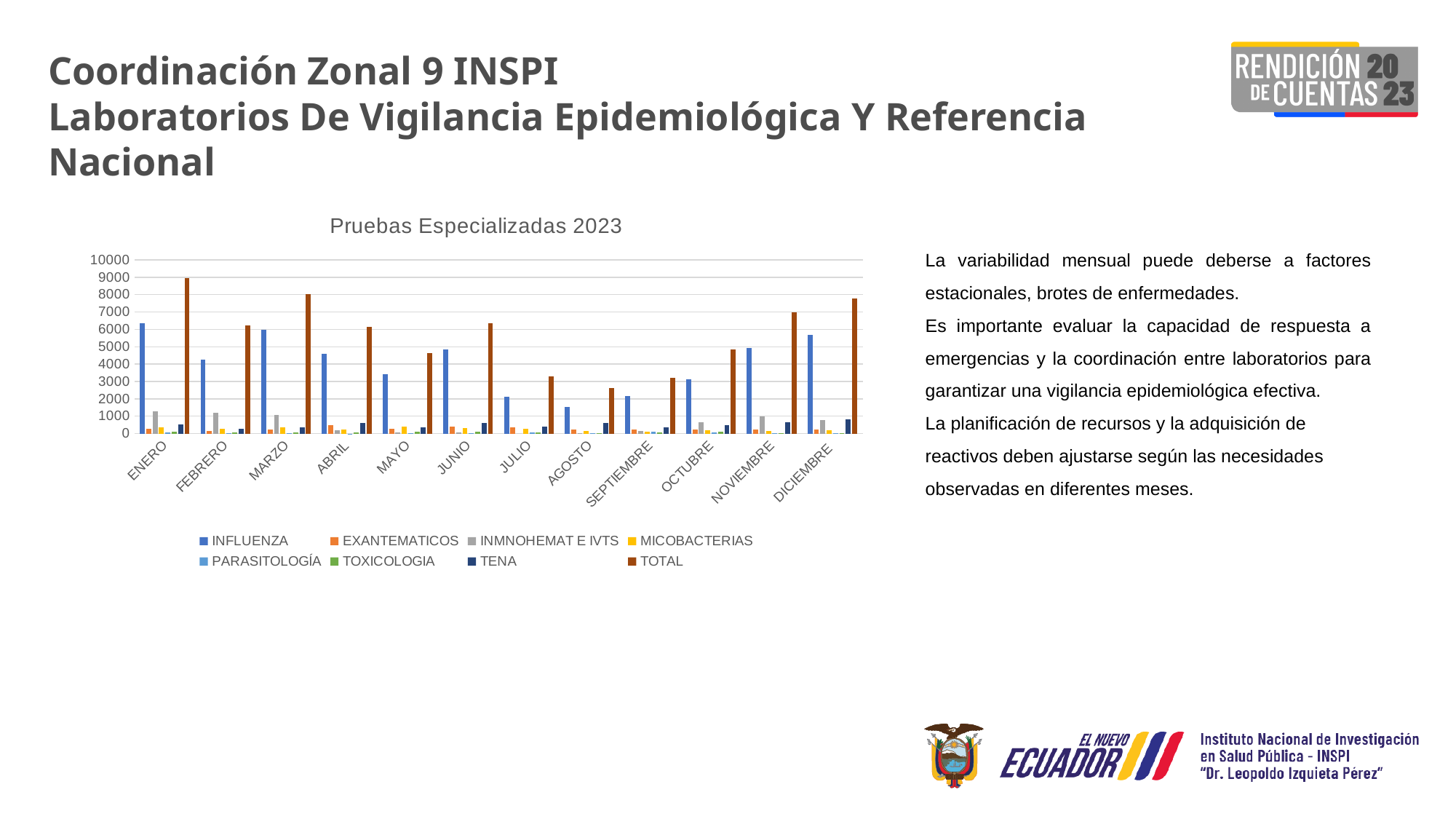
Which is larger, the TOTAL value for MARZO or the TOTAL value for JULIO? MARZO How many series does the chart legend list? 8 How many months (categories) are shown on the x axis of the chart? 12 In which month is the INFLUENZA bar the highest? ENERO What kind of chart is shown on the slide? Bar chart Is the TOTAL value for ENERO greater or less than 8000? greater Do the TOTAL values rise or fall from JUNIO to AGOSTO? fall Is the INFLUENZA value for AGOSTO greater or less than 2000? less In which month is the TOTAL bar the lowest? AGOSTO Is the TOTAL value for AGOSTO greater or less than 3000? less In which month is the TOTAL bar the highest? ENERO What is the title of the chart? Pruebas Especializadas 2023